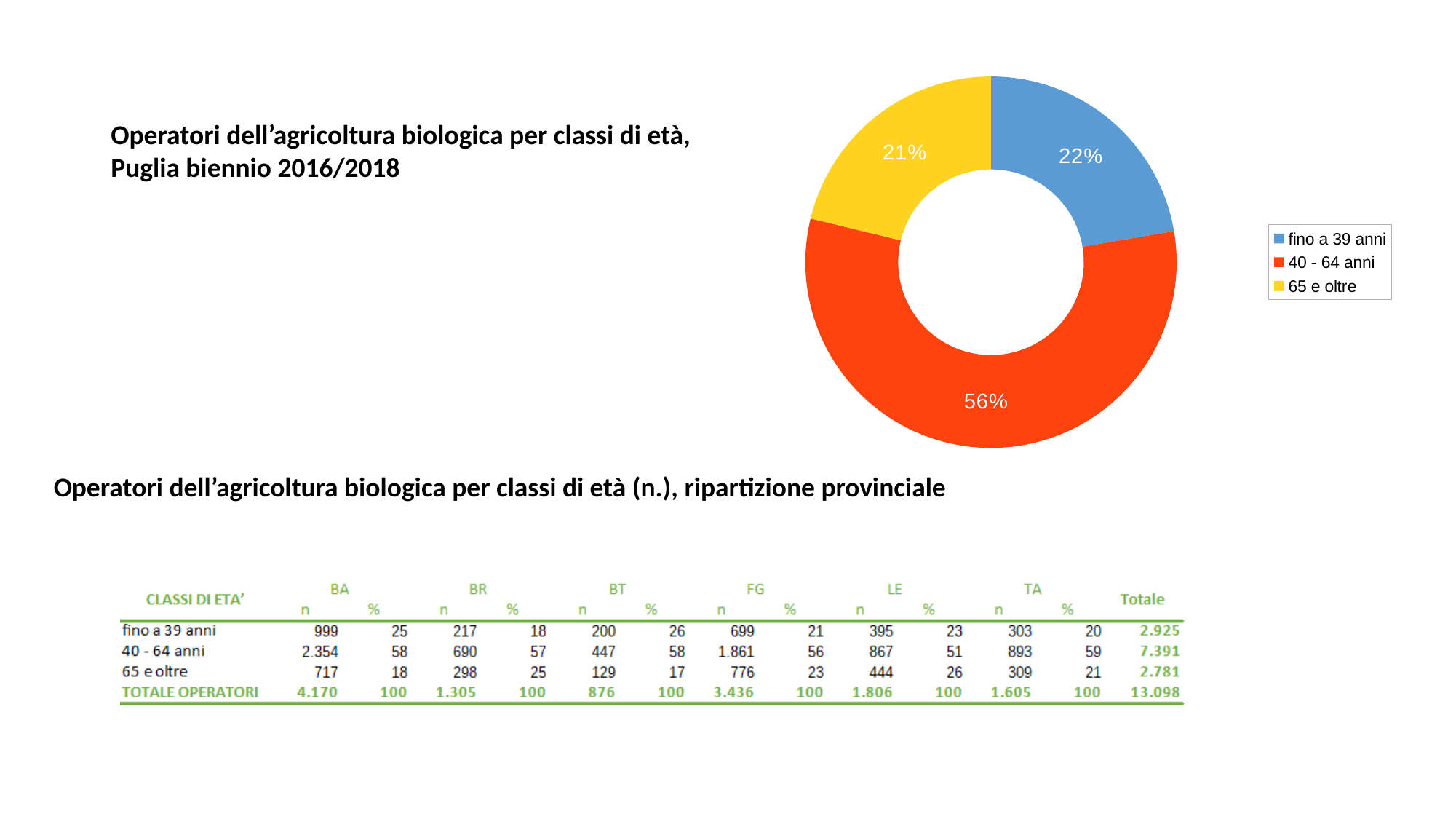
What is the difference in percentage points between the '40 - 64 anni' slice and the 'fino a 39 anni' slice? 34 Which age class has the smallest slice in the chart? 65 e oltre How many age classes are shown in the chart? 3 What is the difference in percentage points between the 'fino a 39 anni' slice and the '65 e oltre' slice? 1 Which is larger: the '40 - 64 anni' slice or the '65 e oltre' slice? 40 - 64 anni What percentage is shown for the 'fino a 39 anni' slice? 22% Which age class has the largest slice in the chart? 40 - 64 anni What percentage is shown for the '65 e oltre' slice? 21% What share of the pie chart does the '40 - 64 anni' slice represent? 56% What is the title of the chart? Operatori dell'agricoltura biologica per classi di età, Puglia biennio 2016/2018 What colour is the '40 - 64 anni' slice in the chart? red What kind of chart is shown on the slide? doughnut chart